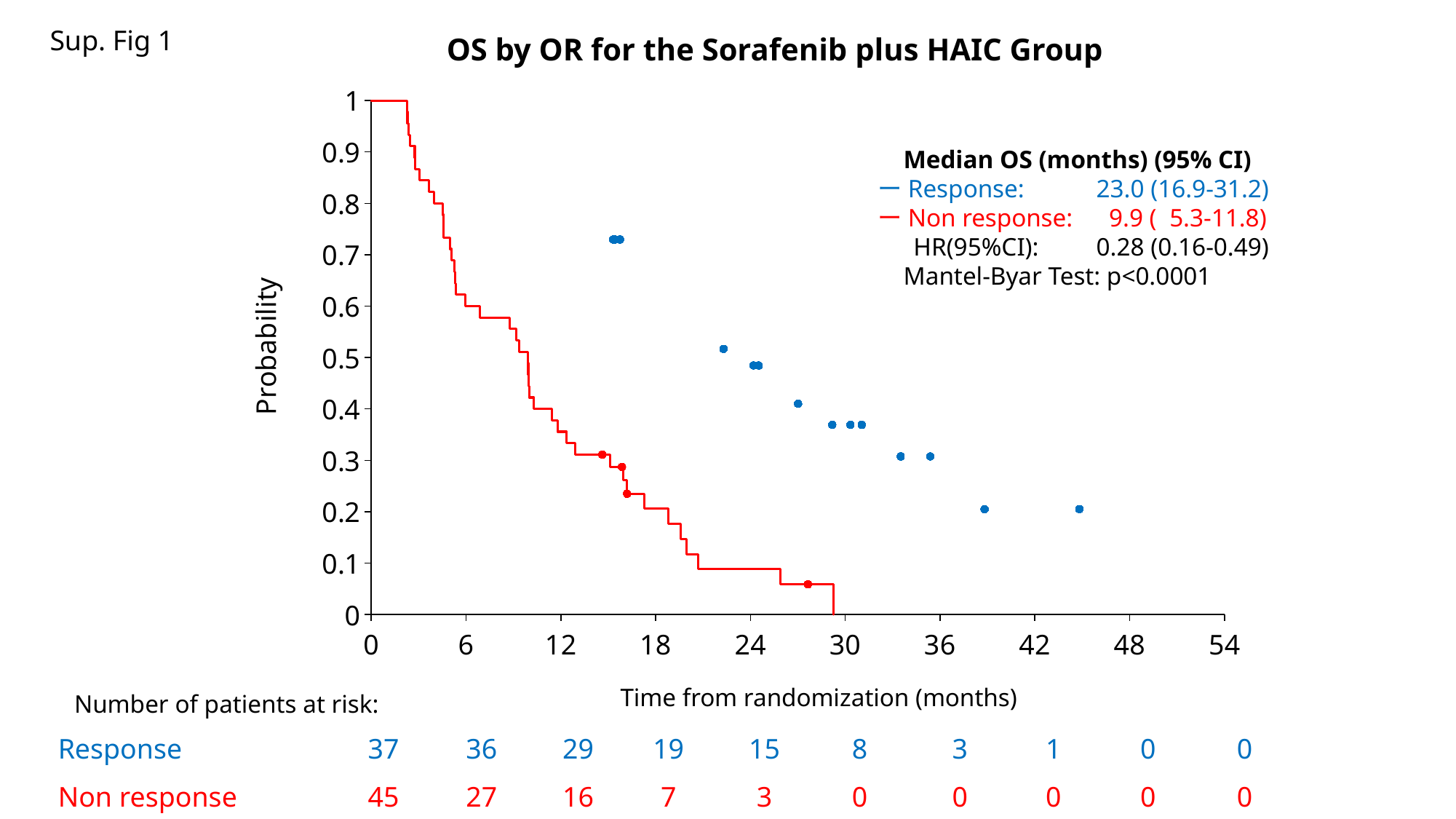
What is the median OS (95% CI) for the Non response group? 9.9 (5.3-11.8) Is the survival probability of the Non response curve at 12 months greater or less than 0.5? less What kind of chart is shown on the slide? Kaplan-Meier survival curve (line chart) What is the difference between the number of Non response and Response patients at risk at time 0? 8 What is the median OS (95% CI) for the Response group? 23.0 (16.9-31.2) How many series does the legend list? 2 What is the hazard ratio (95% CI) shown on the chart? 0.28 (0.16-0.49) What is the Mantel-Byar Test p-value shown on the chart? p<0.0001 What is the title of the chart? OS by OR for the Sorafenib plus HAIC Group How many Response patients were at risk at 24 months? 15 Which group has the higher median OS, Response or Non response? Response How many Non response patients were at risk at time 0? 45